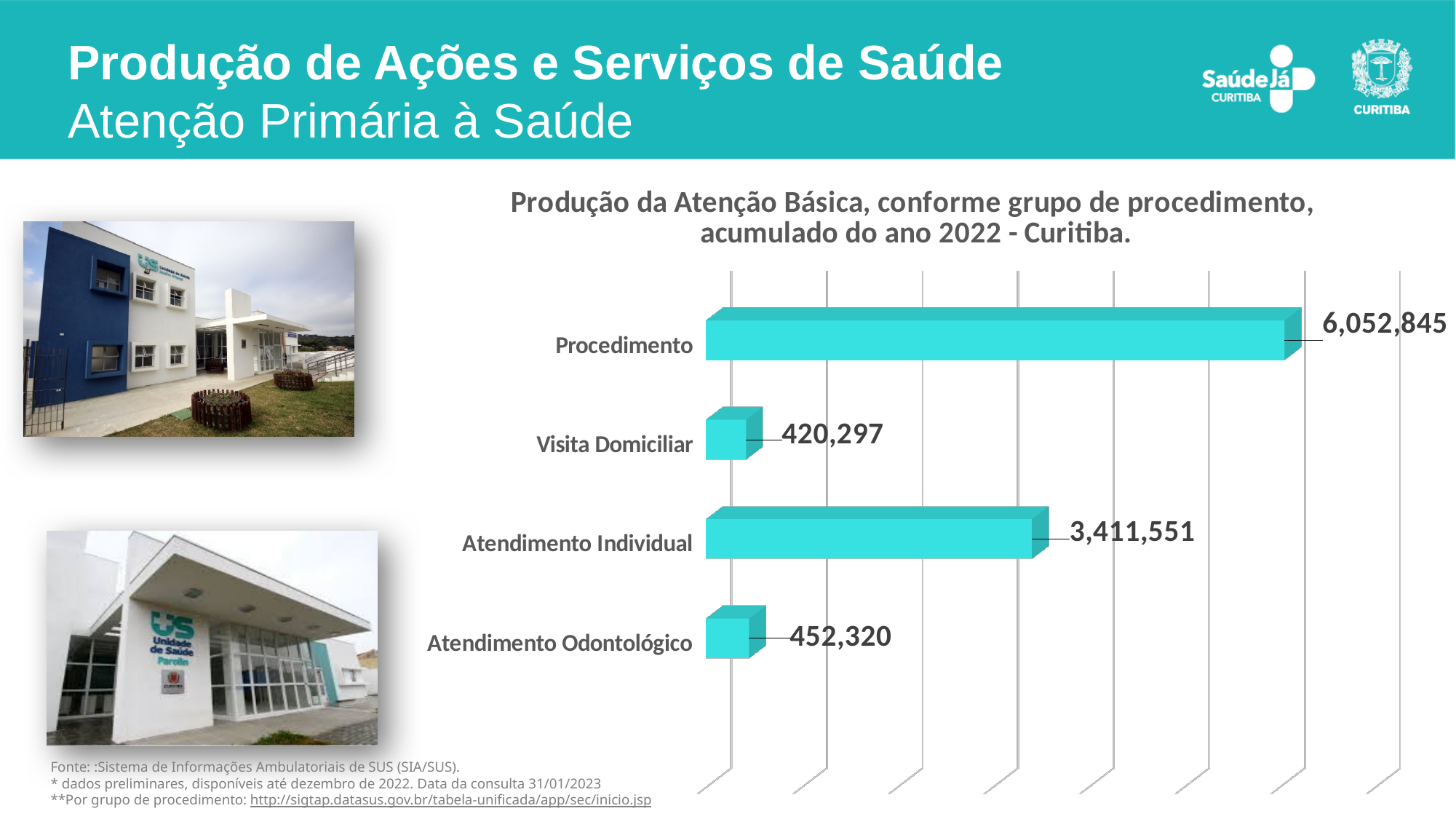
Which category has the lowest value? Visita Domiciliar What is the title of the chart? Produção da Atenção Básica, conforme grupo de procedimento, acumulado do ano 2022 - Curitiba. What is the value for Procedimento? 6,052,845 What kind of chart is shown on the slide? Bar chart Which is larger, the value for Atendimento Individual or the value for Visita Domiciliar? Atendimento Individual What is the value for Atendimento Odontológico? 452,320 What is the value for Atendimento Individual? 3,411,551 What is the value for Visita Domiciliar? 420,297 How many categories are shown in the chart? 4 Which category has the highest value? Procedimento What is the difference between the values for Atendimento Odontológico and Visita Domiciliar? 32,023 What is the difference between the values for Procedimento and Atendimento Individual? 2,641,294